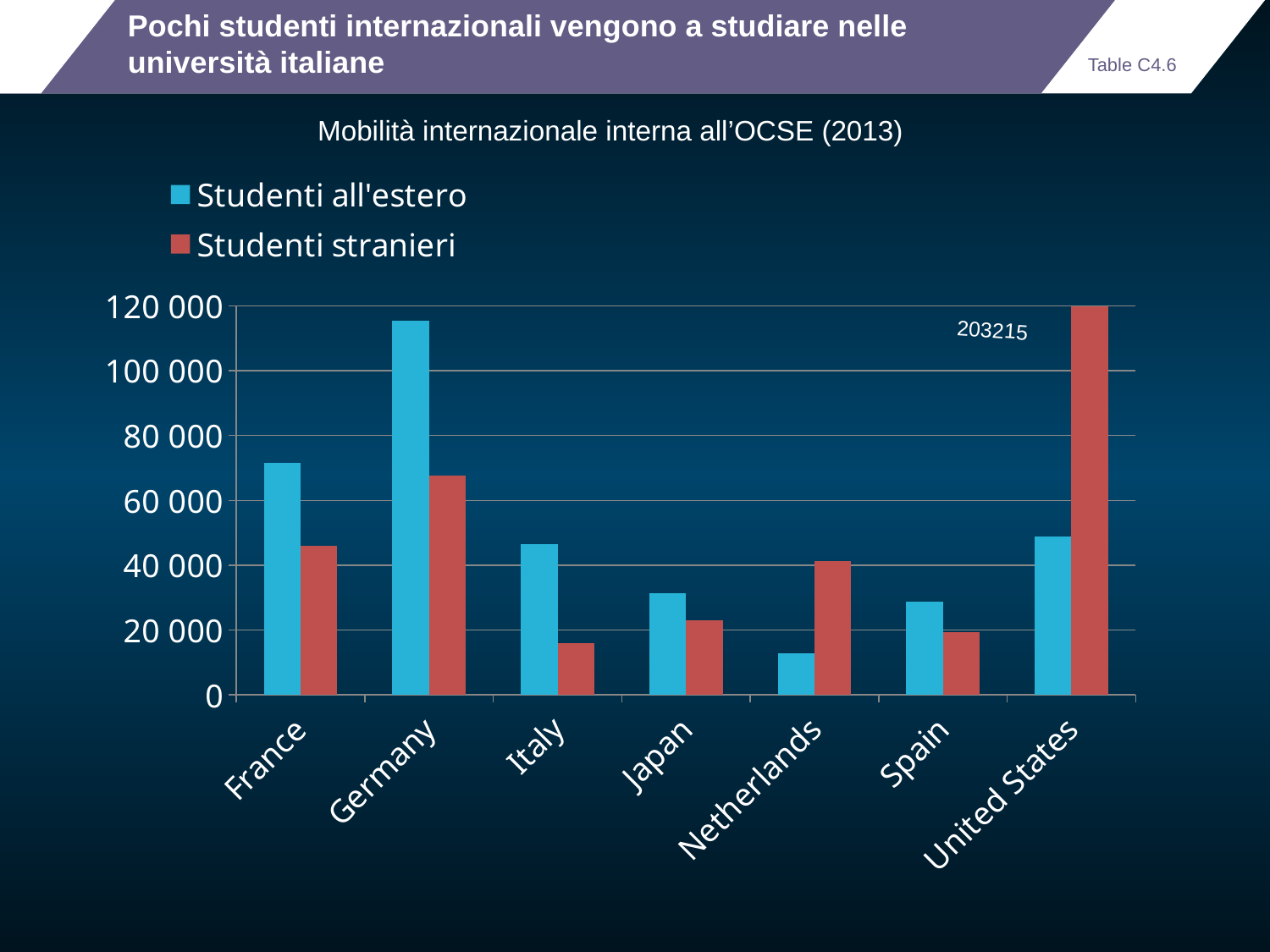
How many series does the chart's legend list? 2 How many countries are shown on the x axis of the chart? 7 What is the title of the chart? Mobilità internazionale interna all'OCSE (2013) Is the value of Studenti stranieri for Italy greater or less than 20 000? less What kind of chart is shown on the slide? Bar chart Is the value of Studenti all'estero for France greater or less than 60 000? greater Which country has the lowest value for Studenti stranieri? Italy Which country has the lowest value for Studenti all'estero? Netherlands Which country has the highest value for Studenti stranieri? United States Which country has the highest value for Studenti all'estero? Germany What is the value of Studenti stranieri for United States? 203215 For Netherlands, which is larger: Studenti all'estero or Studenti stranieri? Studenti stranieri